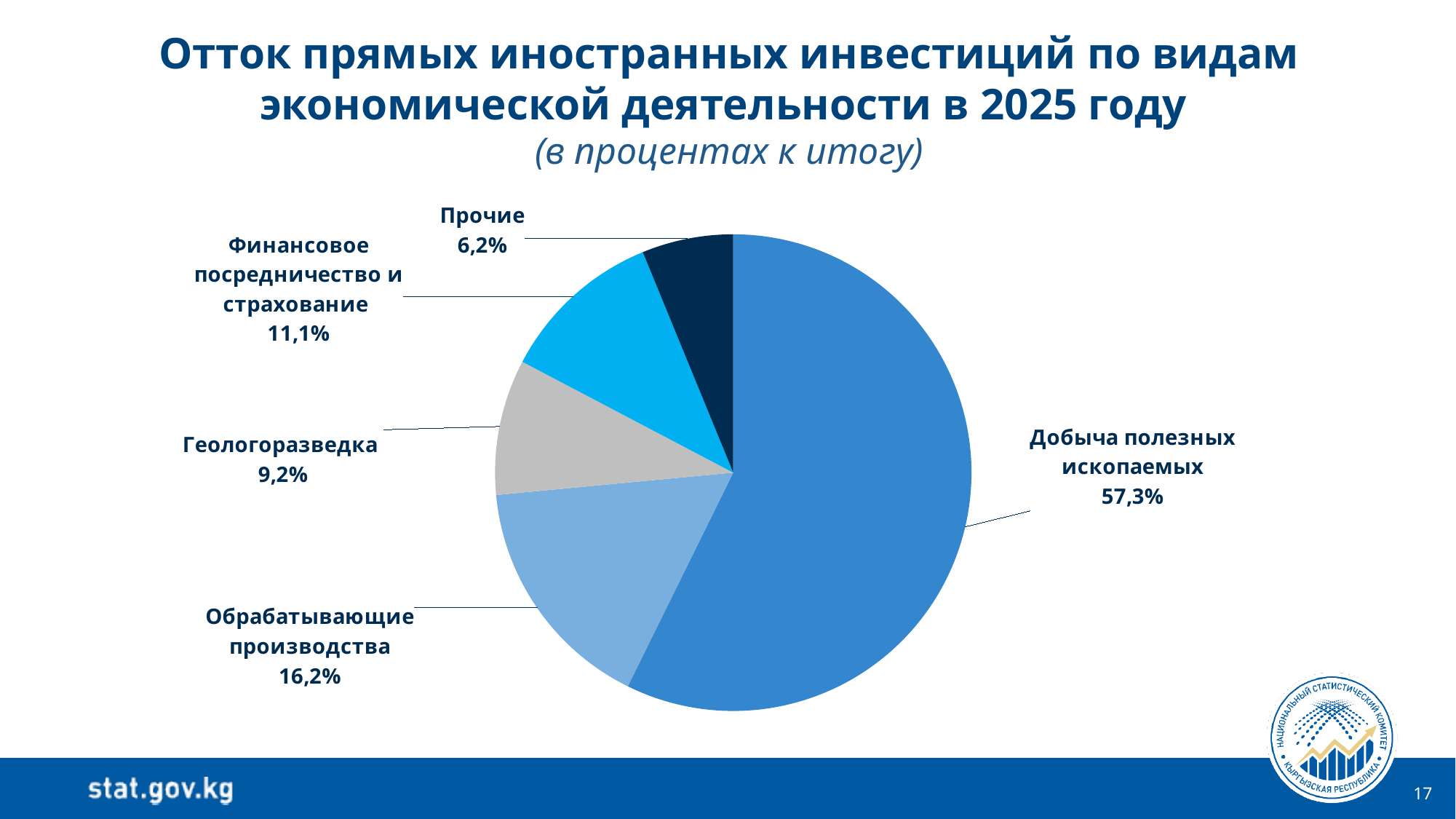
What share of the pie does Добыча полезных ископаемых have? 57,3% Which category has the largest slice of the pie? Добыча полезных ископаемых Which category has the smallest slice of the pie? Прочие How many categories are shown in the pie chart? 5 What is the value shown for Геологоразведка? 9,2% What is the difference in percentage points between Обрабатывающие производства and Геологоразведка? 7,0 What is the value shown for Финансовое посредничество и страхование? 11,1% What is the value shown for Обрабатывающие производства? 16,2% What type of chart is shown on the slide? Pie chart Which is larger: Финансовое посредничество и страхование or Геологоразведка? Финансовое посредничество и страхование What is the value shown for Прочие? 6,2% What year does the chart title refer to? 2025